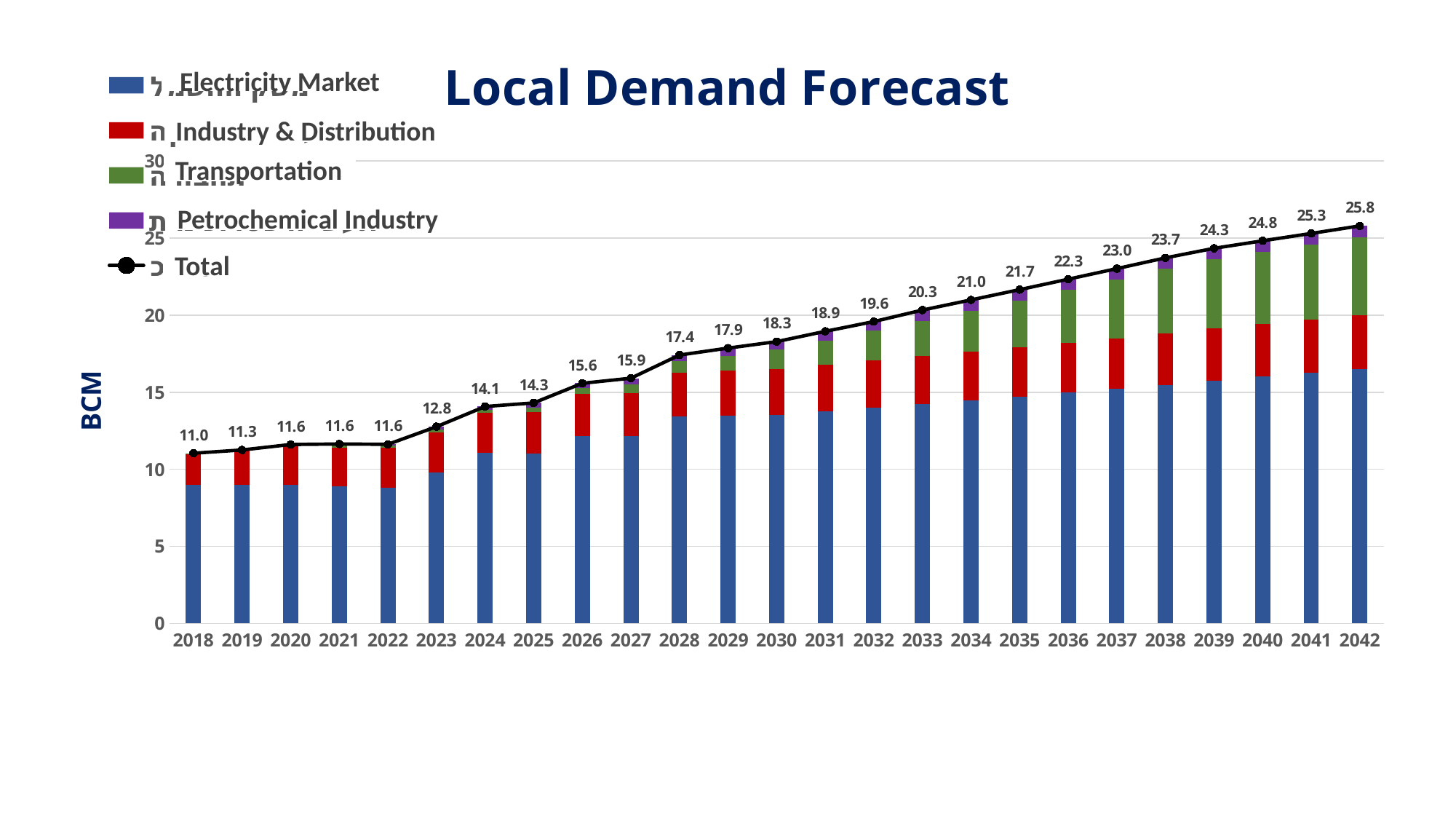
How many years are shown on the x axis? 25 What is the Total value shown for 2018? 11.0 What is the difference between the Total value for 2042 and the Total value for 2018? 14.8 Do the Total values rise or fall from 2018 to 2042? rise How many series does the legend list? 5 What is the title of the chart? Local Demand Forecast What is the Total value shown for 2030? 18.3 Is the value for Electricity Market in 2042 greater or less than 15? greater Is the value for Electricity Market in 2018 greater or less than 10? less Which is larger, the Total value for 2028 or the Total value for 2027? 2028 Which year has the lowest Total value? 2018 Which year has the highest Total value? 2042